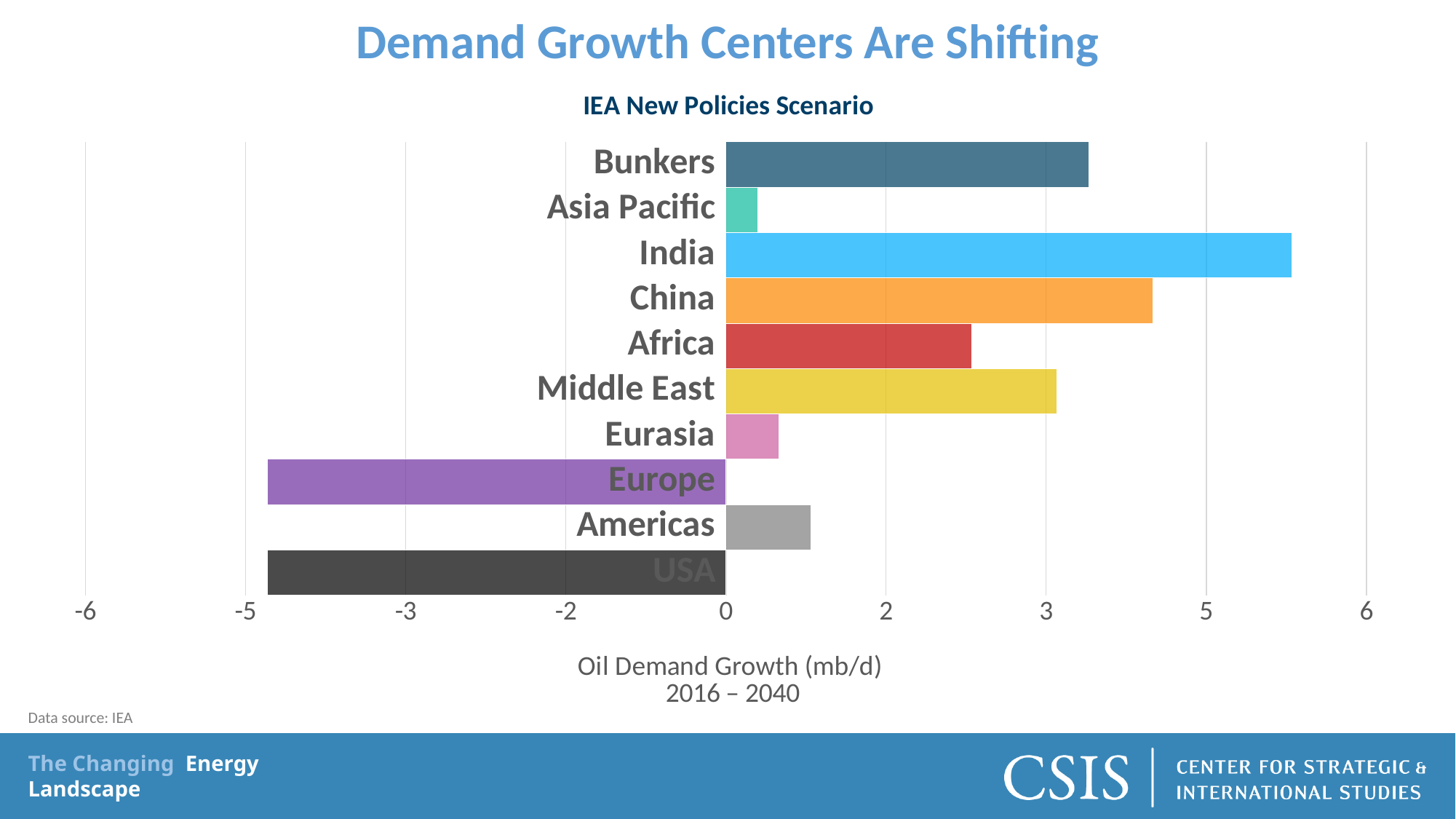
Is the value for Asia Pacific greater or less than 1? less Which is larger, the value for Bunkers or the value for Africa? Bunkers Is the value for India greater or less than 5? greater How many categories are plotted in the chart? 10 Is the value for Europe greater or less than -4? less Which is larger, the value for India or the value for China? India What is the label of the x axis? Oil Demand Growth (mb/d) 2016 – 2040 What kind of chart is shown on the slide? bar chart Which category has the highest oil demand growth? India What is the title of the chart? IEA New Policies Scenario